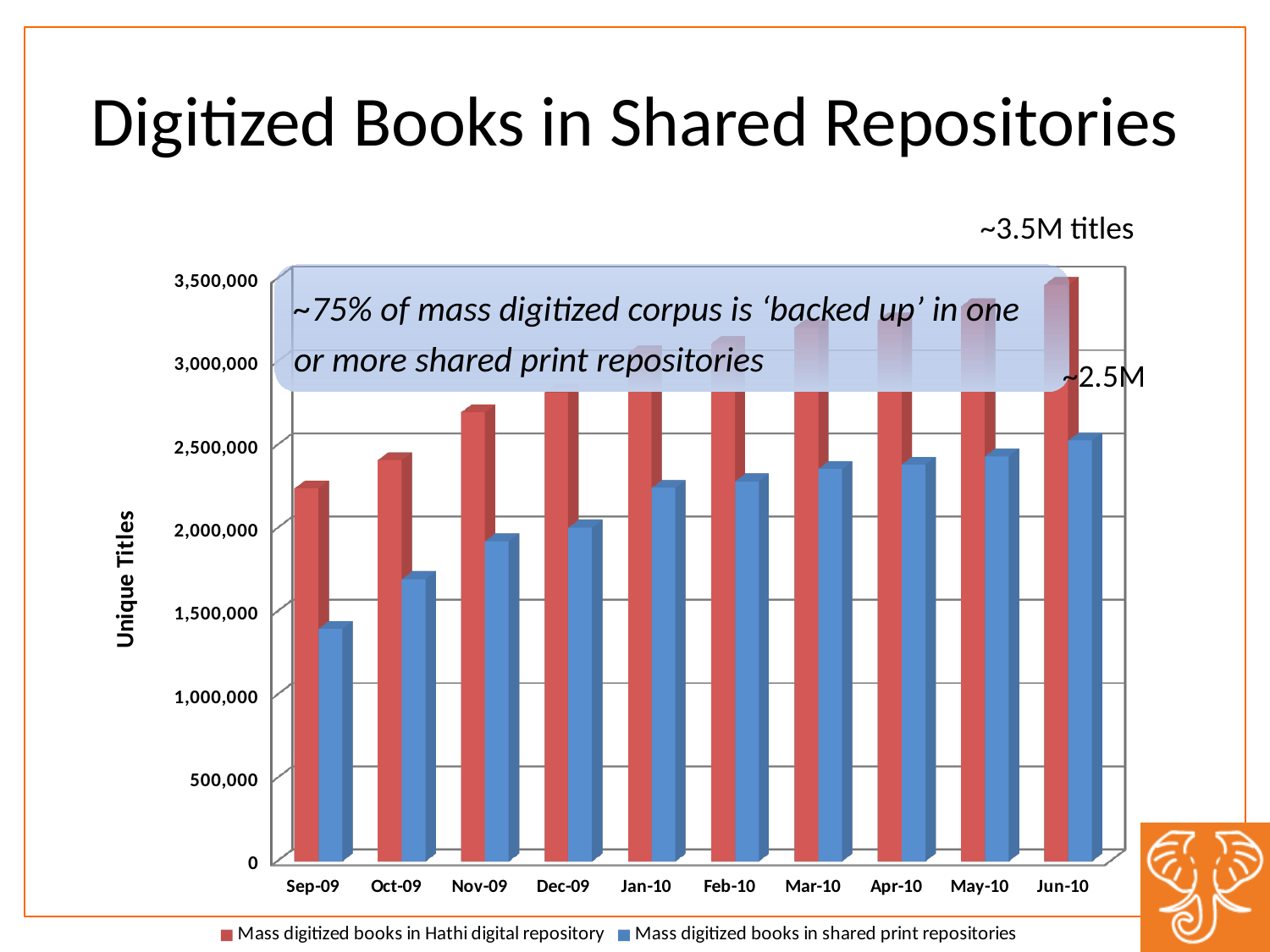
Is the value for Mass digitized books in Hathi digital repository in Jun-10 greater or less than 3,000,000? greater Is the value for Mass digitized books in shared print repositories in Sep-09 greater or less than 1,500,000? less How many months are shown along the x axis of the chart? 10 Do the values for Mass digitized books in shared print repositories rise or fall from Sep-09 to Jun-10? rise What is the title of the chart's vertical axis? Unique Titles How many series does the chart's legend list? 2 In which month is the value for Mass digitized books in Hathi digital repository highest? Jun-10 Which colour represents Mass digitized books in Hathi digital repository in the chart? red In which month is the value for Mass digitized books in shared print repositories lowest? Sep-09 Is the value for Mass digitized books in shared print repositories in Jan-10 greater or less than 2,000,000? greater What kind of chart is shown on the slide? bar chart In Jan-10, which is larger: Mass digitized books in Hathi digital repository or Mass digitized books in shared print repositories? Mass digitized books in Hathi digital repository